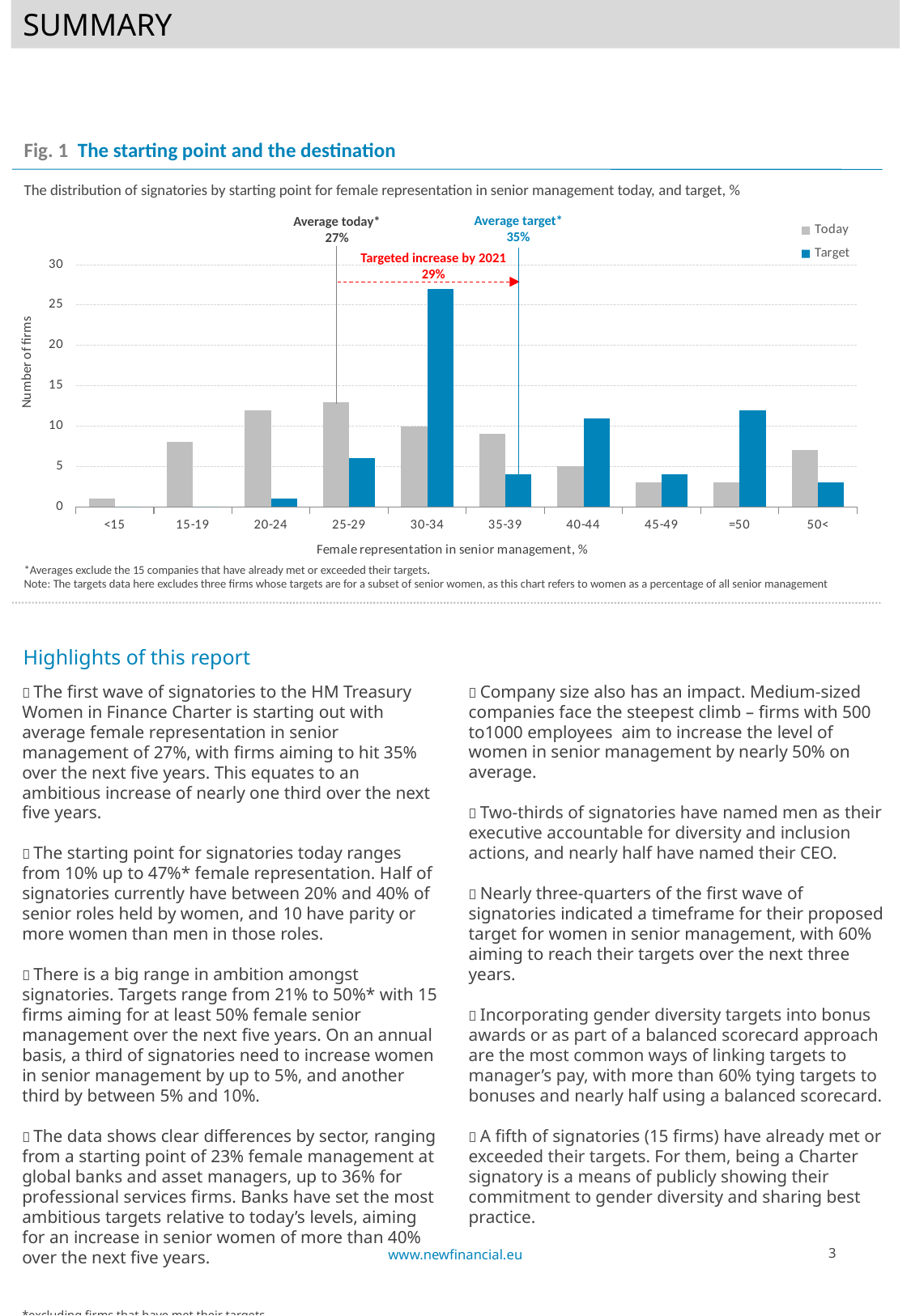
Is the Target value for 30-34 greater or less than 25? greater Which category has the highest Target bar in Fig. 1? 30-34 What is the y-axis label of Fig. 1? Number of firms What is the average target value annotated on Fig. 1? 35% Is the Target value for =50 greater or less than 10? greater How many series does the legend of Fig. 1 list? 2 What kind of chart is Fig. 1? bar chart How many categories are shown on the x axis of Fig. 1? 10 Is the Today value for 15-19 greater or less than 10? less What is the average today value annotated on Fig. 1? 27% For the 25-29 category, which is larger: the Today bar or the Target bar? Today For the 40-44 category, which is larger: the Today bar or the Target bar? Target